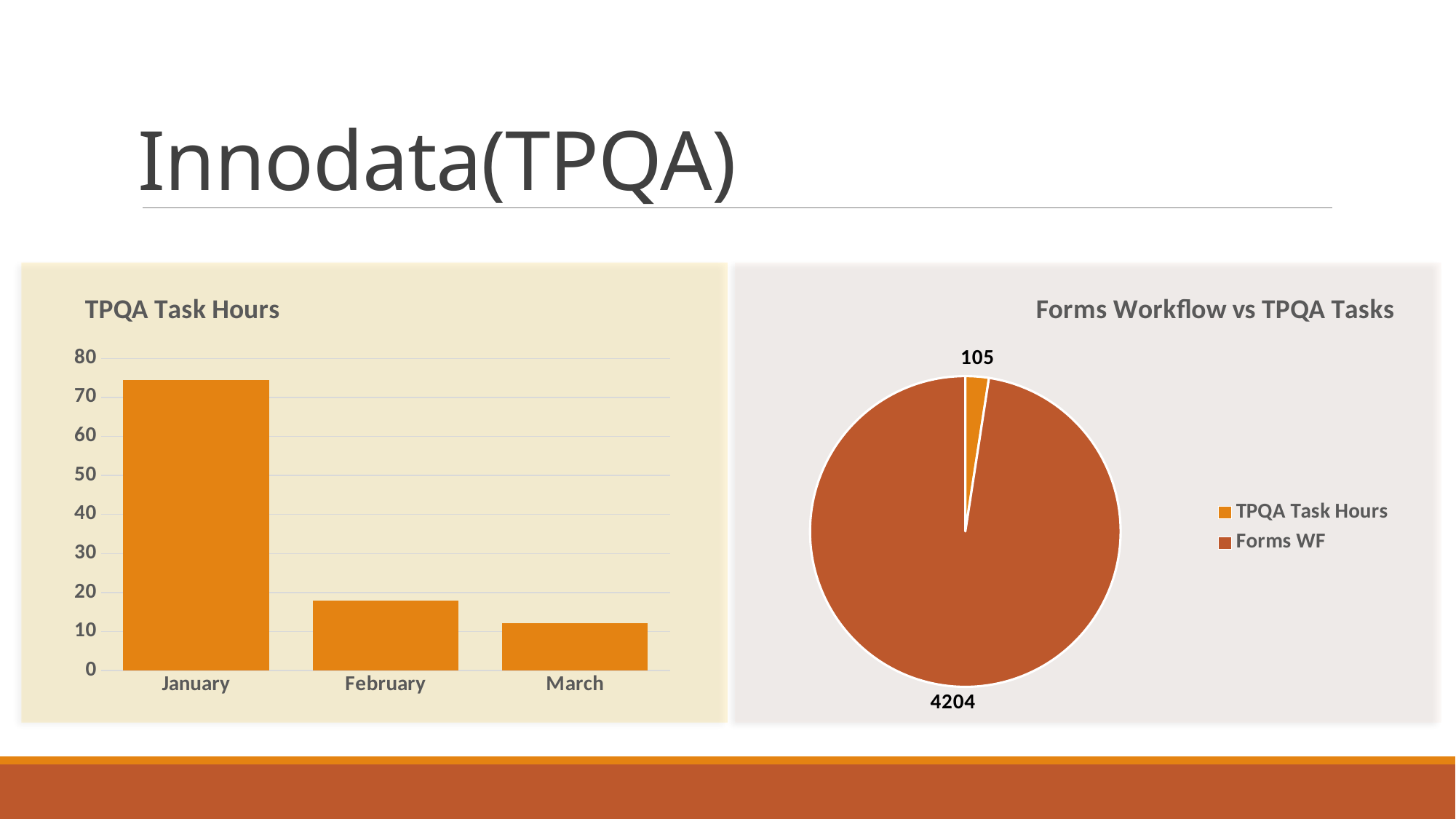
In the 'TPQA Task Hours' chart, which month has the highest value? January How many entries does the legend of the 'Forms Workflow vs TPQA Tasks' chart list? 2 In the 'Forms Workflow vs TPQA Tasks' chart, what is the value for Forms WF? 4204 In the 'TPQA Task Hours' chart, which is larger, the value for February or the value for March? February In the 'TPQA Task Hours' chart, is the value for January greater or less than 70? greater In the 'TPQA Task Hours' chart, is the value for March greater or less than 10? greater In the 'TPQA Task Hours' chart, which month has the lowest value? March How many months are shown in the 'TPQA Task Hours' chart? 3 In the 'Forms Workflow vs TPQA Tasks' chart, what is the value for TPQA Task Hours? 105 What kind of chart is 'TPQA Task Hours'? bar chart In the 'TPQA Task Hours' chart, is the value for February greater or less than 20? less In the 'TPQA Task Hours' chart, do the values rise or fall from January to March? fall